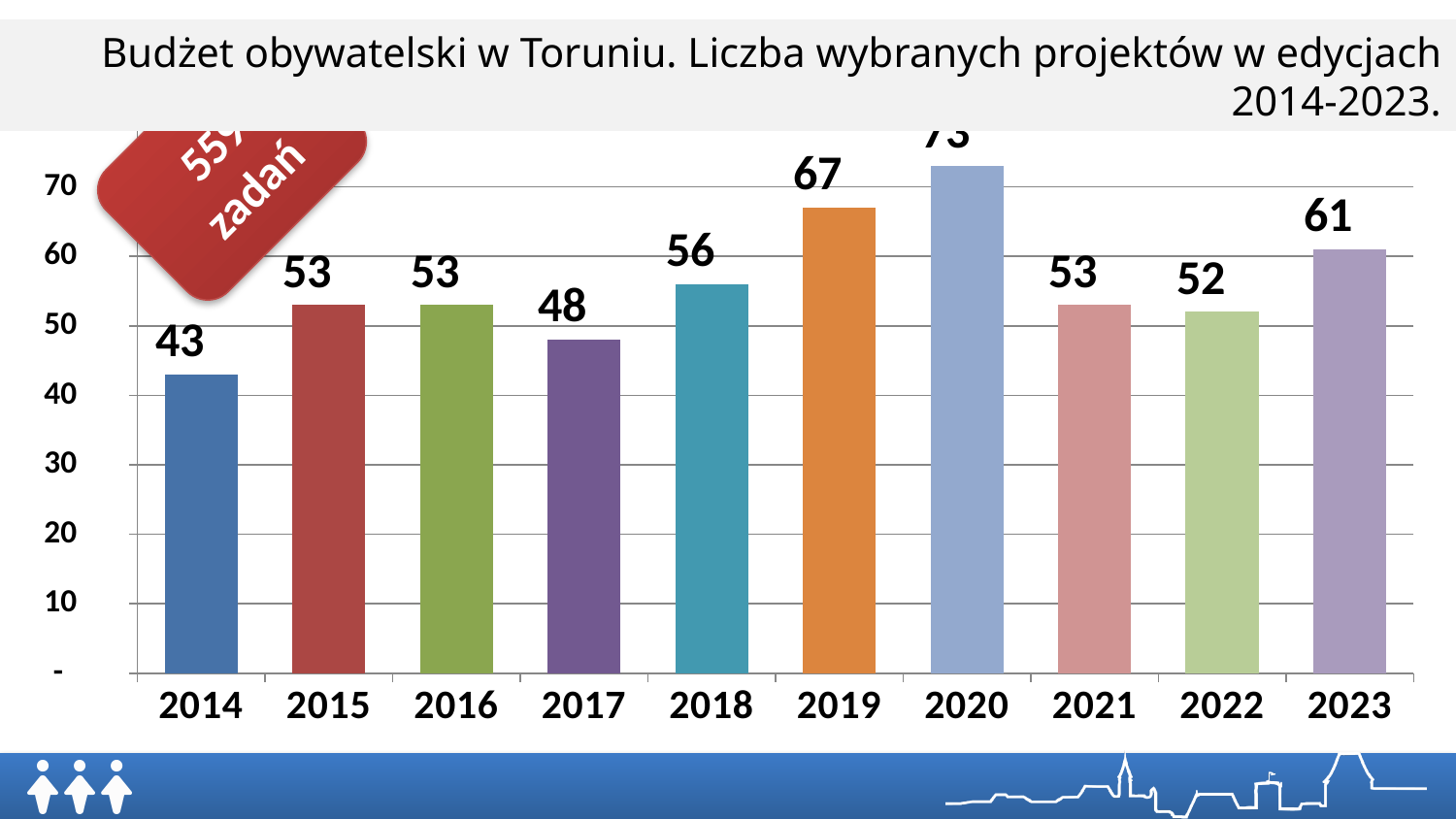
What type of chart is shown on the slide? bar chart What is the value shown for 2019? 67 Is the value for 2020 greater or less than 70? greater Which year has the lowest value in the chart? 2014 What is the value shown for 2023? 61 What is the title of the chart on the slide? Budżet obywatelski w Toruniu. Liczba wybranych projektów w edycjach 2014-2023. Which is larger, the value for 2021 or the value for 2022? 2021 Which year has the highest bar in the chart? 2020 What is the difference between the values for 2019 and 2018? 11 What is the value shown for 2017? 48 What is the number of selected projects for 2014? 43 How many years (categories) are shown on the x axis of the chart? 10